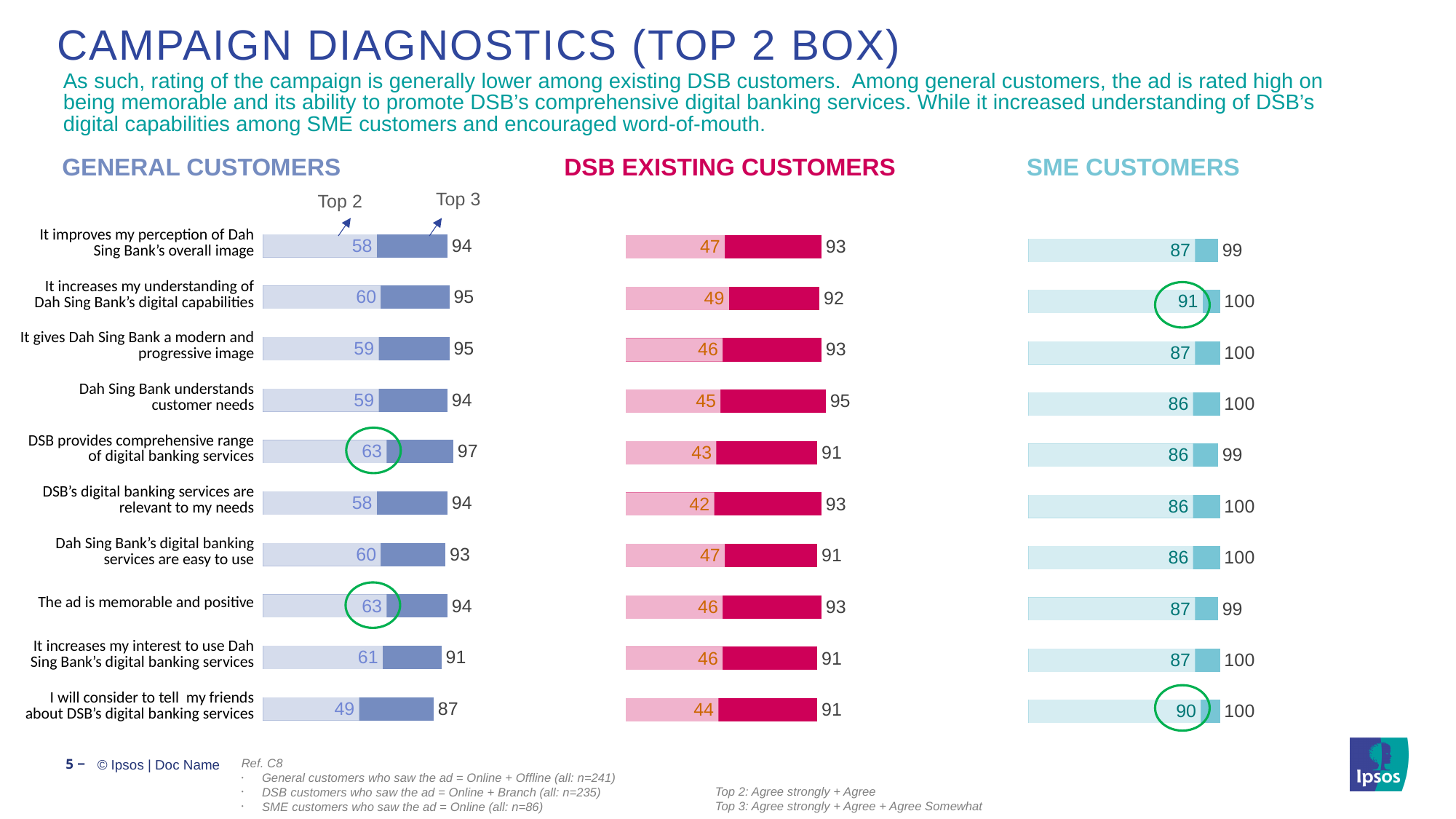
In the General Customers chart, which statement has the lowest Top 2 value? I will consider to tell my friends about DSB's digital banking services In the General Customers chart, what is the difference between the Top 3 and Top 2 values for "DSB provides comprehensive range of digital banking services"? 34 In the DSB Existing Customers chart, which statement has the highest Top 2 value? It increases my understanding of Dah Sing Bank's digital capabilities For "It improves my perception of Dah Sing Bank's overall image", is the Top 2 value higher in the General Customers chart or the DSB Existing Customers chart? General Customers How many measures (Top 2 and Top 3) are shown for each statement in the General Customers chart? 2 In the General Customers chart, what is the Top 2 value for "The ad is memorable and positive"? 63 In the DSB Existing Customers chart, what is the difference in Top 2 values between "It increases my understanding of Dah Sing Bank's digital capabilities" and "DSB's digital banking services are relevant to my needs"? 7 In the SME Customers chart, which statement has the highest Top 2 value? It increases my understanding of Dah Sing Bank's digital capabilities How many statements are plotted in the General Customers chart? 10 What type of chart is used for the DSB Existing Customers data? Bar chart In the SME Customers chart, what is the Top 2 value for "I will consider to tell my friends about DSB's digital banking services"? 90 In the DSB Existing Customers chart, what is the Top 3 value for "Dah Sing Bank understands customer needs"? 95